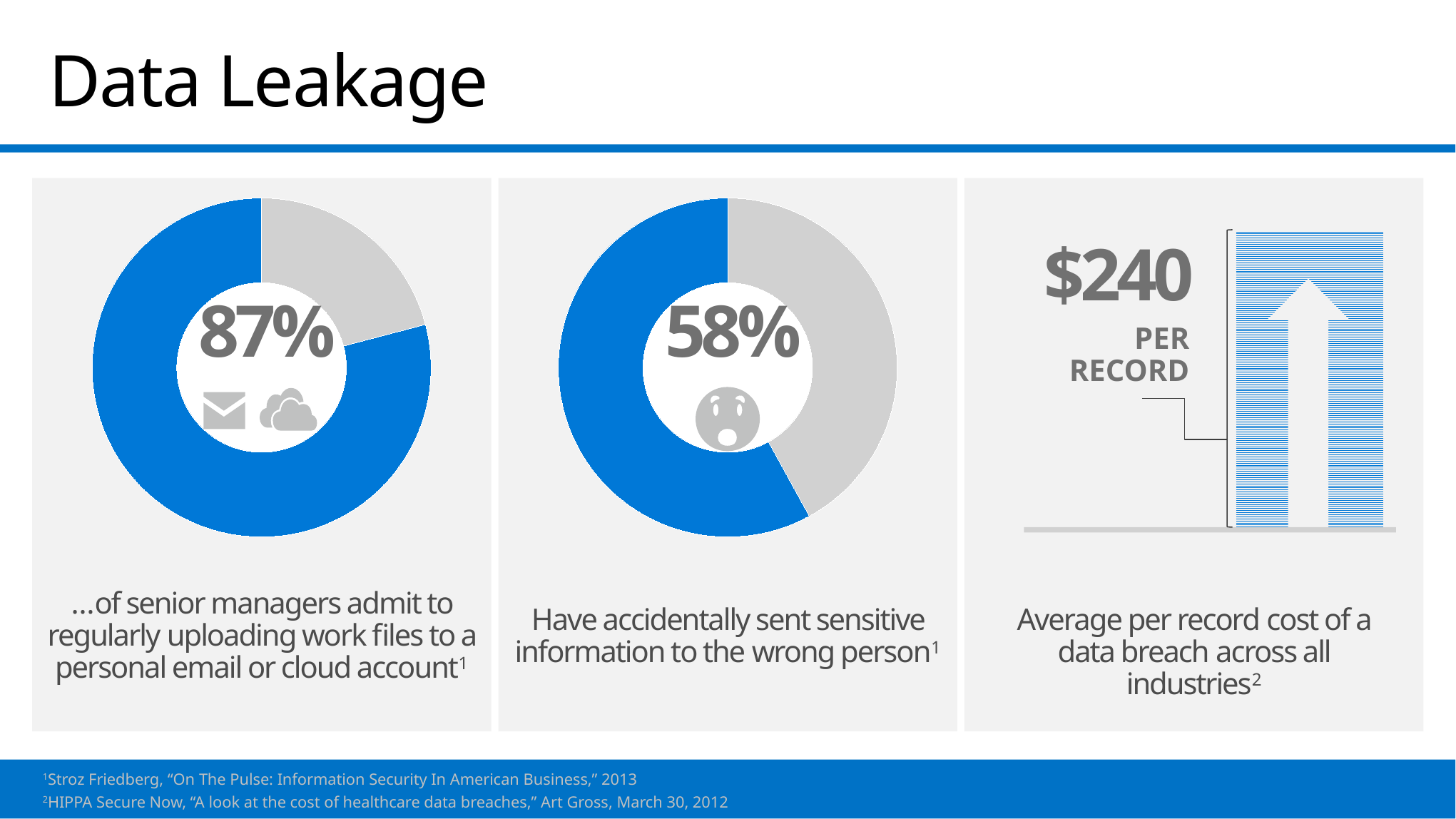
What kind of chart is used in the left and middle panels of the slide? Donut (pie) chart What is the title of the slide containing the donut charts? Data Leakage In the middle donut chart, is the blue portion greater or less than 50%? greater What colour is used for the highlighted (percentage) segment in both donut charts? Blue What percentage is shown in the left donut chart about senior managers uploading work files to a personal email or cloud account? 87% In the left donut chart, what share of the ring is filled in blue? 87% How many segments does each donut chart on the slide have? 2 What is the difference in percentage points between the left donut chart (87%) and the middle donut chart (58%)? 29 percentage points Which donut chart shows the larger percentage, the left one (uploading work files) or the middle one (sent to wrong person)? The left one (87%) In the middle donut chart, what share of the ring is filled in blue? 58% What percentage is shown in the middle donut chart about accidentally sending sensitive information to the wrong person? 58% What is the average per record cost of a data breach across all industries shown in the right panel? $240